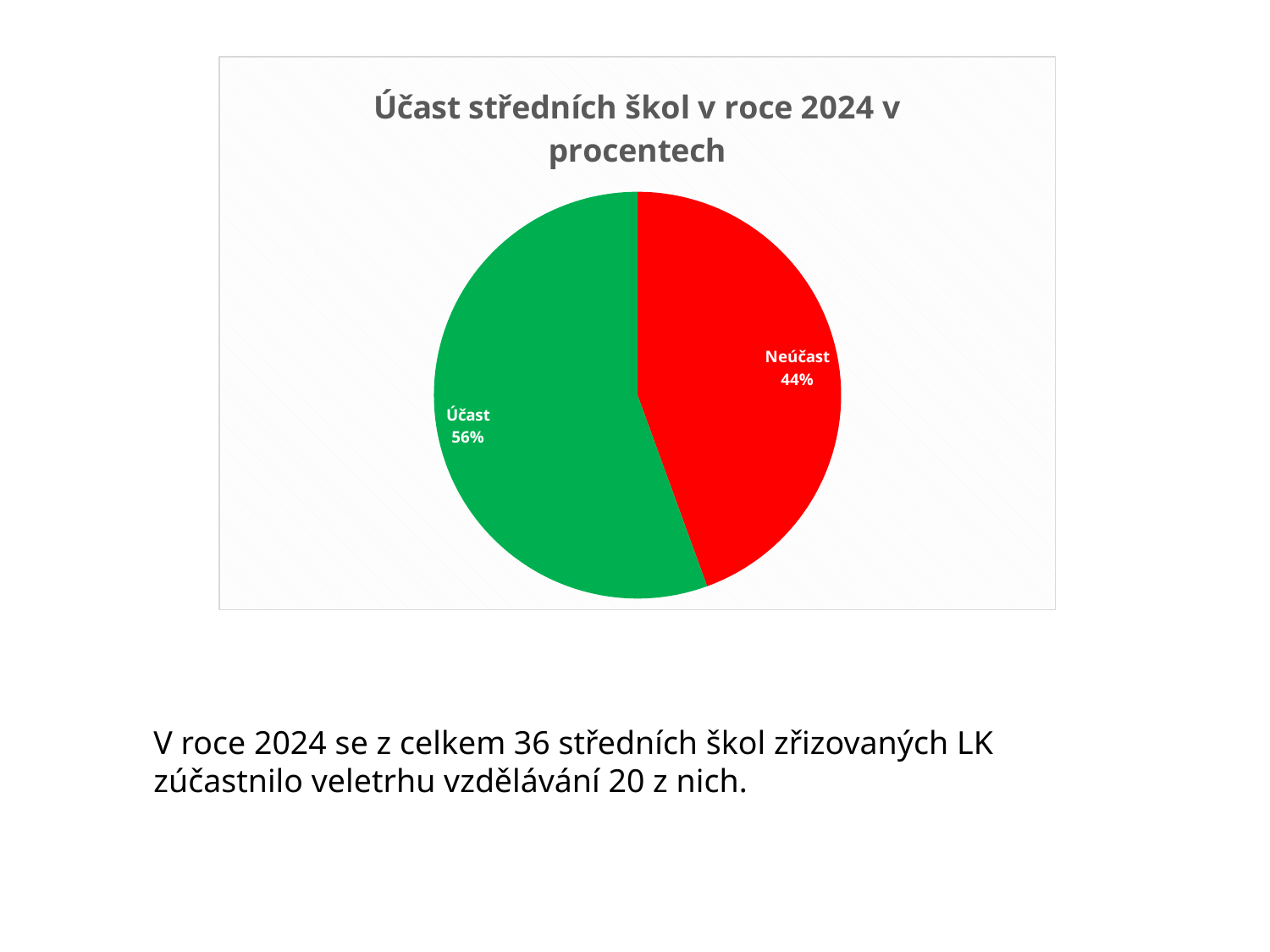
Which slice is the smallest in the pie chart? Neúčast What kind of chart is shown on the slide? Pie chart What is the title of the chart? Účast středních škol v roce 2024 v procentech How many slices does the pie chart have? 2 What colour is the Neúčast slice? Red Which is larger, the Účast slice or the Neúčast slice? Účast What is the difference in percentage points between the Účast and Neúčast slices? 12% What share of the pie does the Neúčast slice represent? 44% What share of the pie does the Účast slice represent? 56% Which slice is the largest in the pie chart? Účast What is the total of the two slices shown in the pie chart? 100%